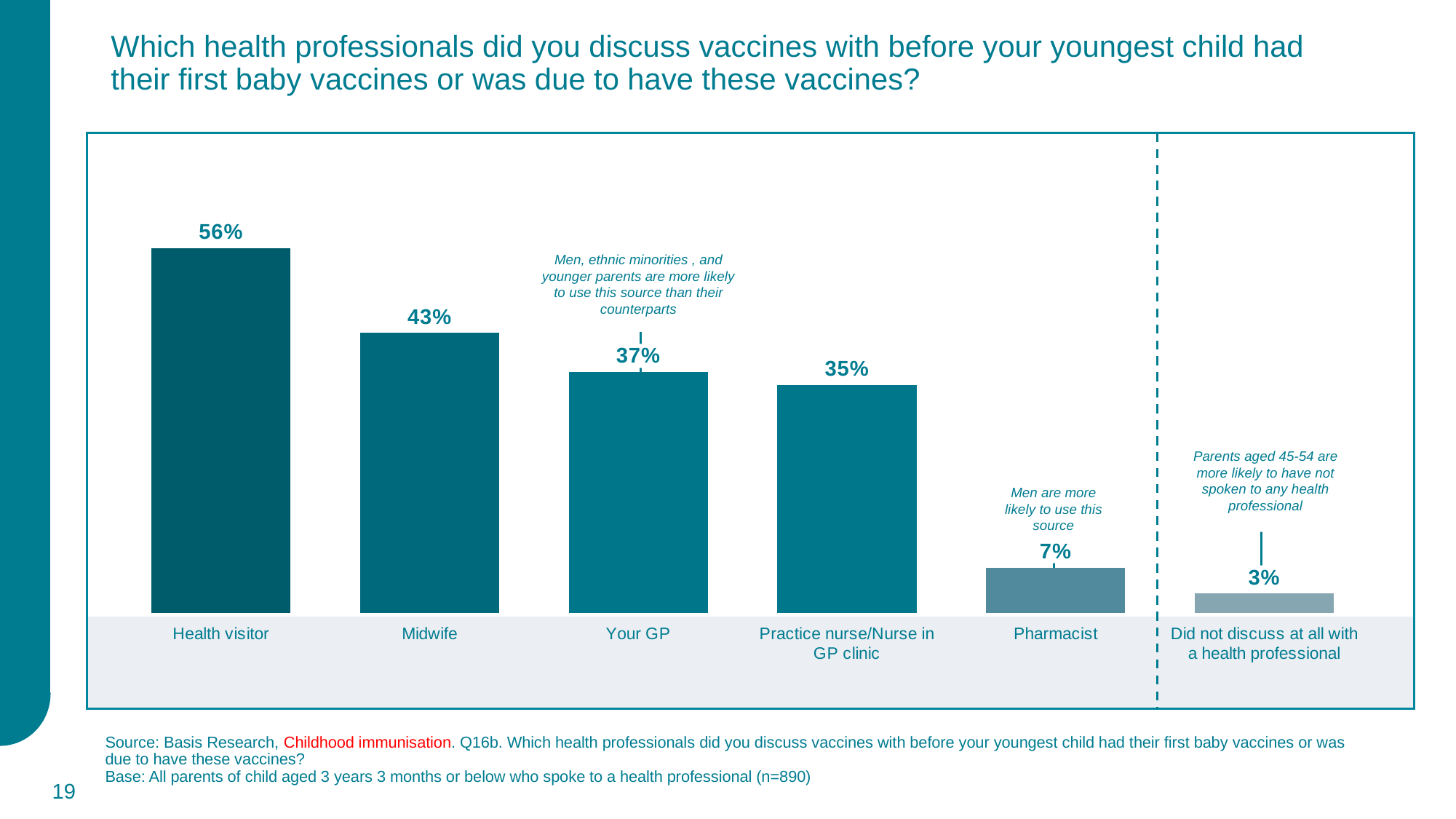
What is the value shown for Midwife? 43% What is the difference between the values for Health visitor and Midwife? 13% What percentage is shown for Your GP? 37% What is the value for Practice nurse/Nurse in GP clinic? 35% What percentage of parents discussed vaccines with a health visitor? 56% Which health professional has the highest percentage? Health visitor How many categories are shown on the chart? 6 Which category has the lowest value on the chart? Did not discuss at all with a health professional Which is larger, the value for Pharmacist or the value for Practice nurse/Nurse in GP clinic? Practice nurse/Nurse in GP clinic Do the values rise or fall from left to right across the categories? Fall What type of chart is shown on the slide? Bar chart What percentage of parents did not discuss at all with a health professional? 3%